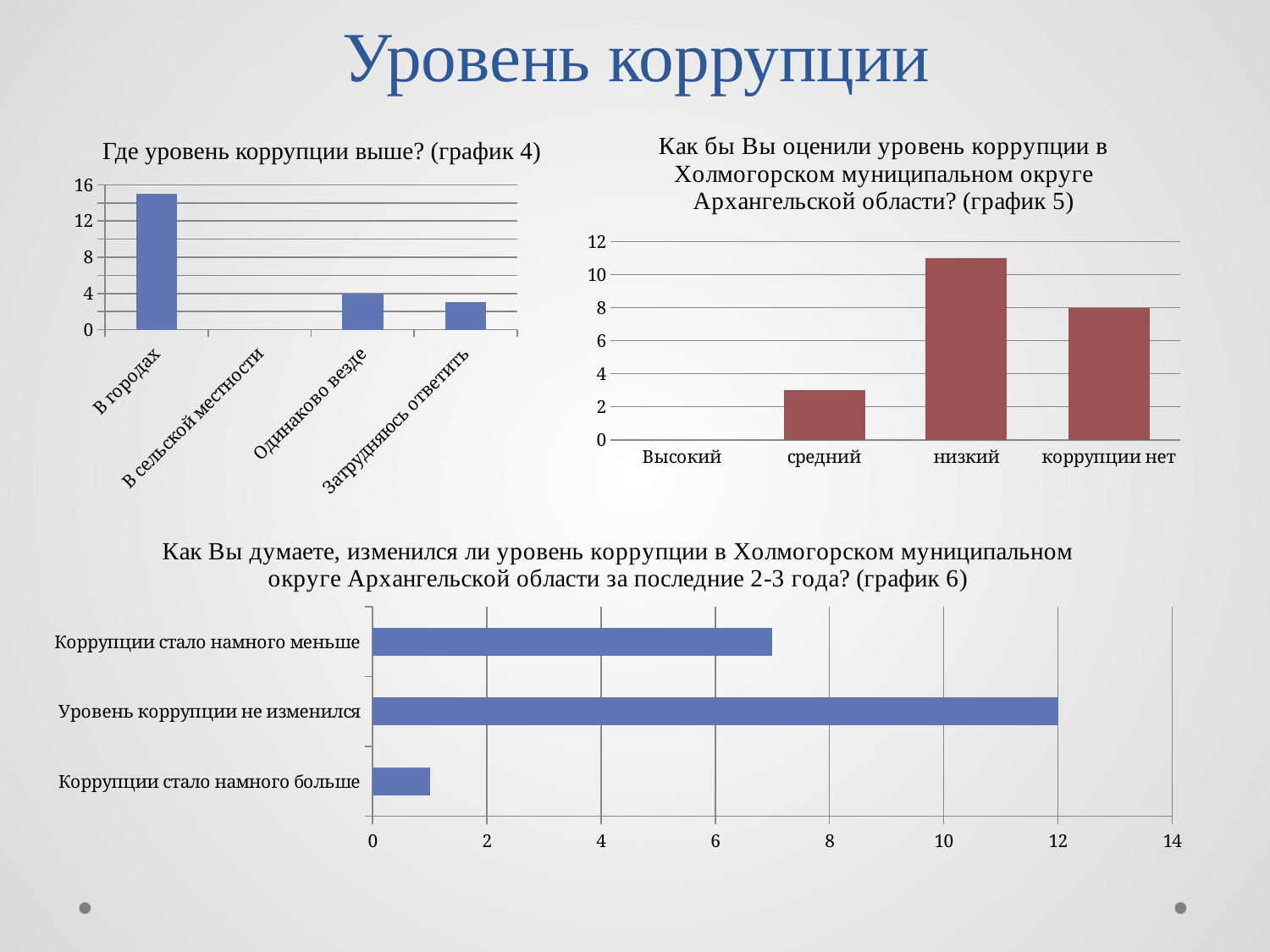
In the chart 'график 5' (top right), is the value for 'низкий' greater or less than 10? greater In the chart 'Где уровень коррупции выше? (график 4)', how many categories are shown on the x axis? 4 In the chart 'Где уровень коррупции выше? (график 4)', which category has the highest value? В городах In the chart 'график 6' (bottom), what is the value for 'Уровень коррупции не изменился'? 12 In the chart 'график 5' (top right), which category has the lowest value? Высокий What kind of chart is 'график 6' at the bottom of the slide? bar chart In the chart 'график 6' (bottom), which category has the lowest value? Коррупции стало намного больше In the chart 'график 5' (top right), what is the value for 'коррупции нет'? 8 In the chart 'Где уровень коррупции выше? (график 4)', which category has the lowest value? В сельской местности In the chart 'Где уровень коррупции выше? (график 4)', is the value for 'В городах' greater or less than 12? greater In the chart 'Где уровень коррупции выше? (график 4)', what is the value for 'Одинаково везде'? 4 In the chart 'график 5' (top right), which category has the highest value? низкий